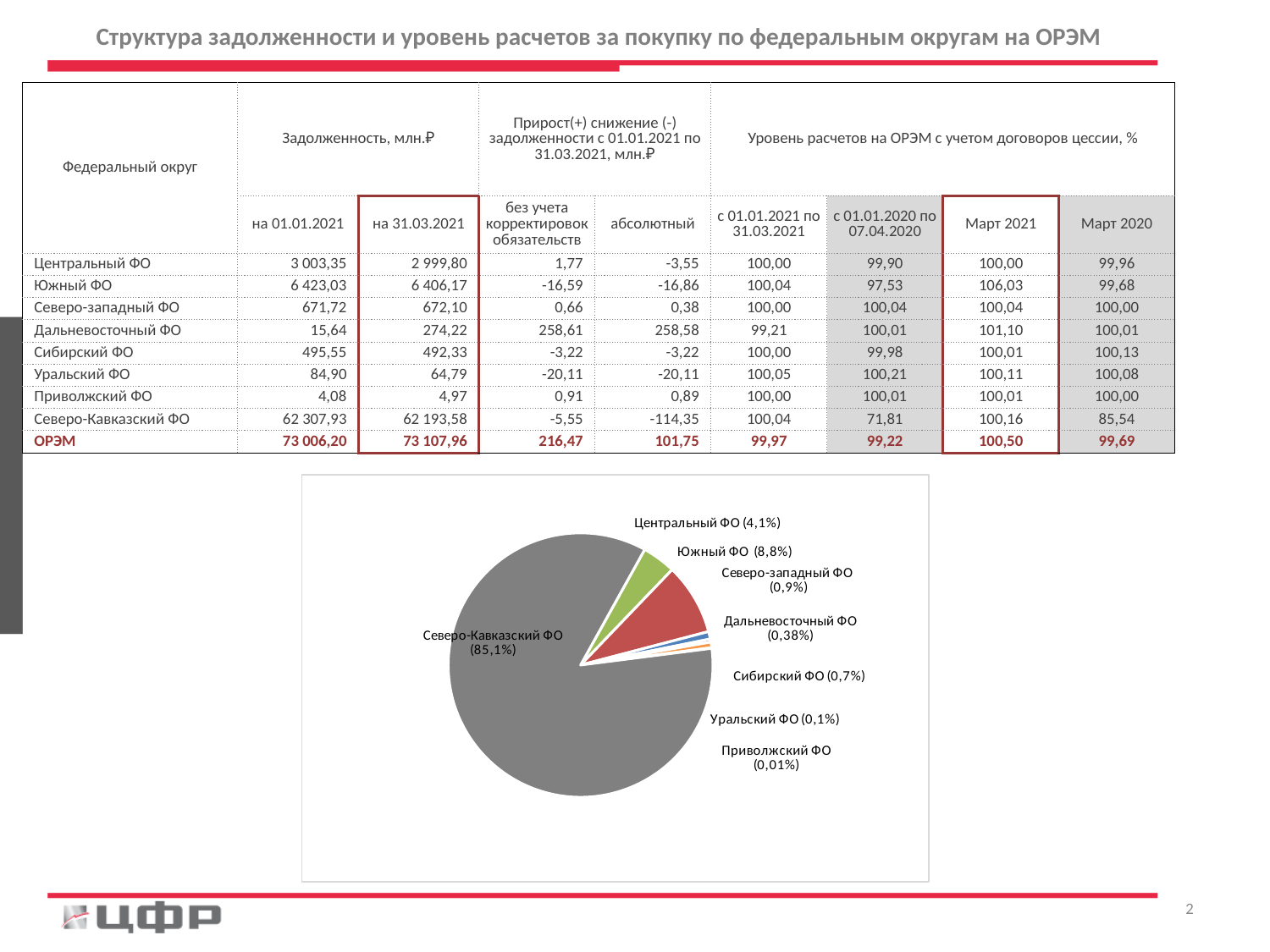
What kind of chart is shown on the slide? pie chart What is the difference in share between Южный ФО and Центральный ФО? 4,7% How many slices does the pie chart have? 8 Which has a larger share of the pie, Южный ФО or Центральный ФО? Южный ФО Which has a larger share of the pie, Сибирский ФО or Уральский ФО? Сибирский ФО Which slice of the pie chart is the largest? Северо-Кавказский ФО What share of the pie does Северо-Кавказский ФО have? 85,1% What share of the pie does Центральный ФО have? 4,1% What share of the pie does Приволжский ФО have? 0,01% Which slice of the pie chart is the smallest? Приволжский ФО